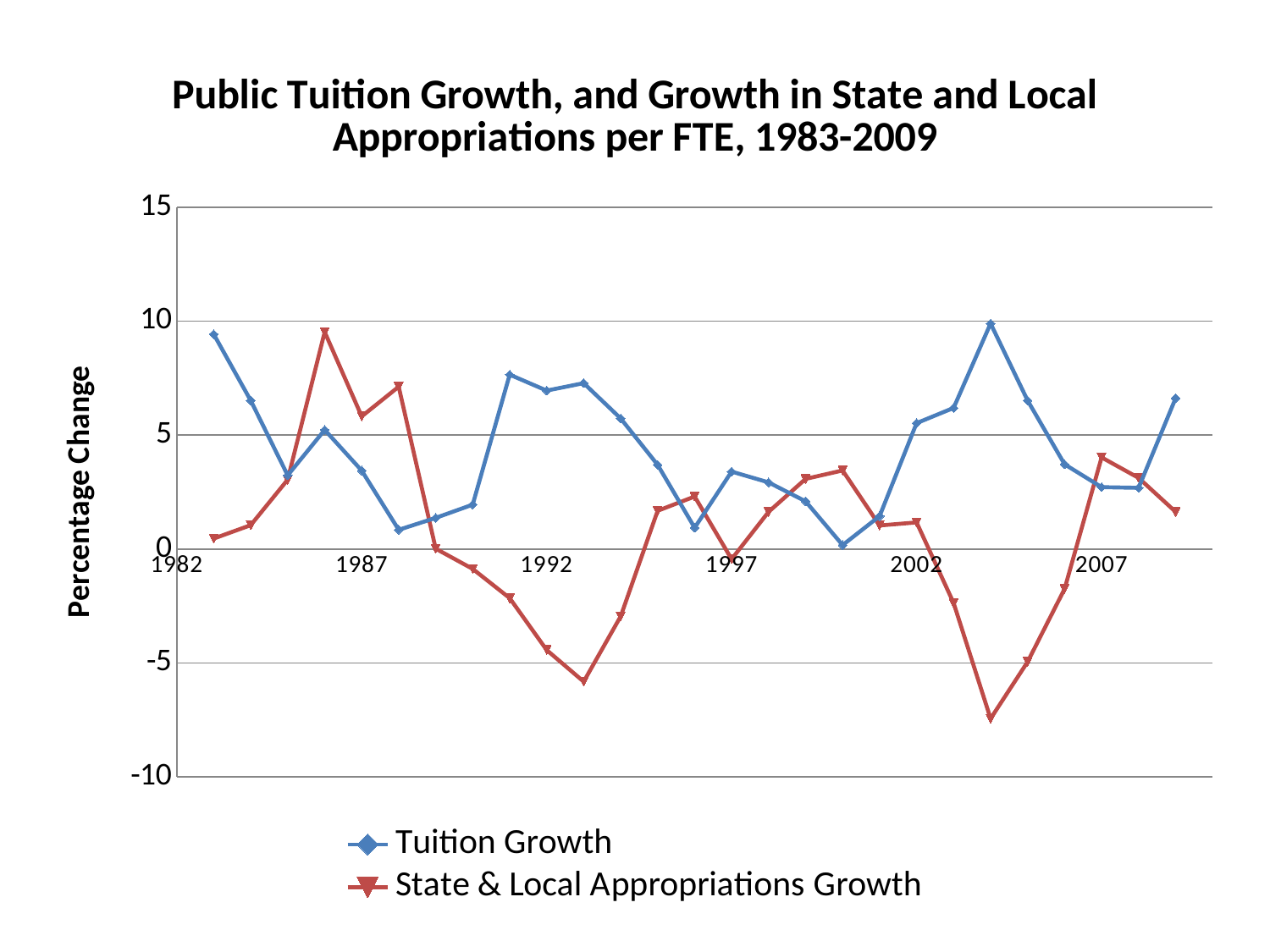
In which year does State & Local Appropriations Growth reach its lowest value? 2004 In 1986, which series has the larger value, Tuition Growth or State & Local Appropriations Growth? State & Local Appropriations Growth Is the value for State & Local Appropriations Growth in 1992 greater or less than 0? less In 1992, which series has the larger value, Tuition Growth or State & Local Appropriations Growth? Tuition Growth What is the label on the vertical axis? Percentage Change In which year does State & Local Appropriations Growth reach its highest value? 1986 Is the value for Tuition Growth in 1992 greater or less than 5? greater What kind of chart is shown on the slide? line chart What is the title of the chart? Public Tuition Growth, and Growth in State and Local Appropriations per FTE, 1983-2009 Is the value for State & Local Appropriations Growth in 2004 greater or less than -5? less Does State & Local Appropriations Growth rise or fall between 2004 and 2007? rise How many series does the legend list? 2